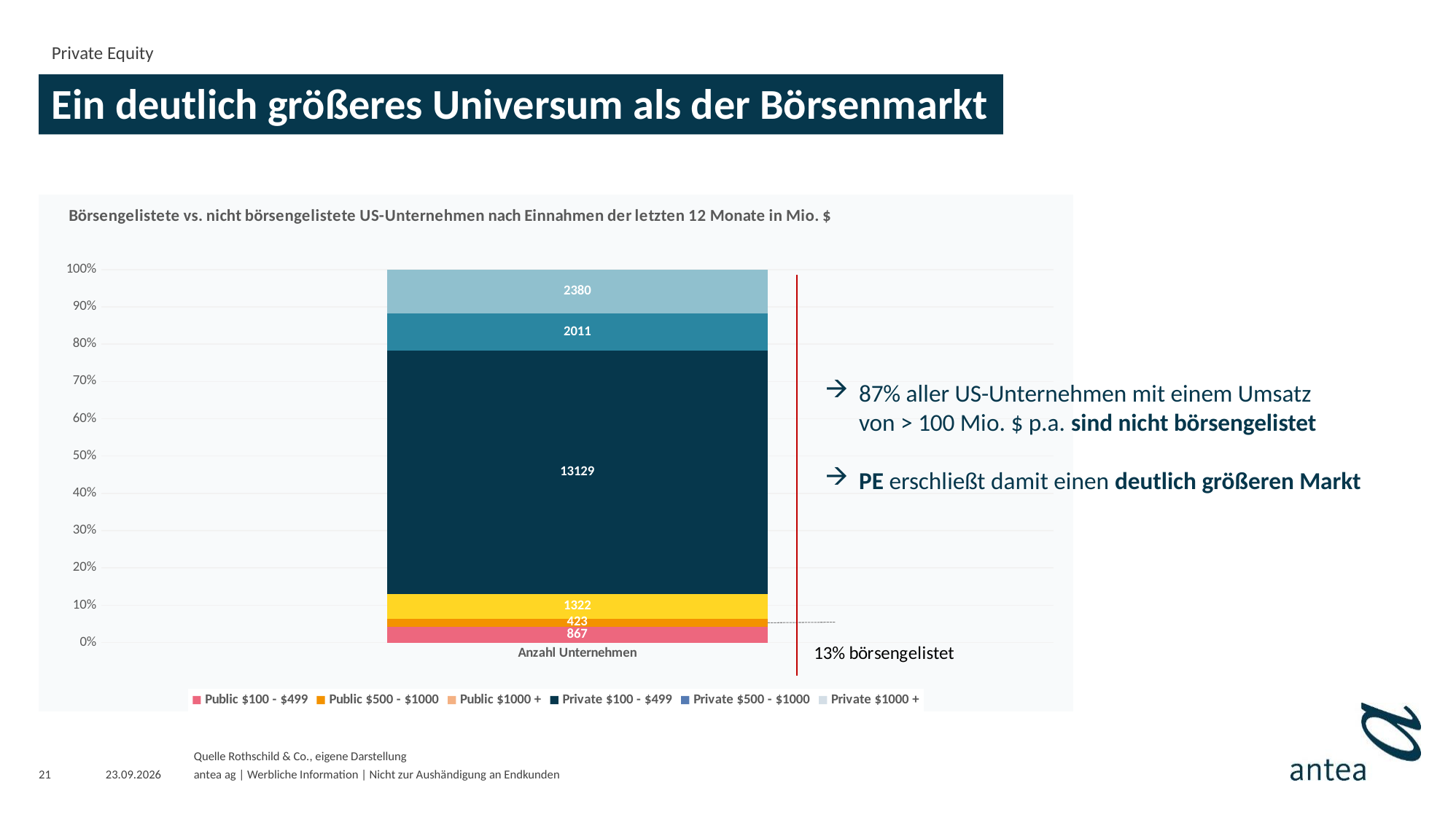
What kind of chart is shown on the slide? Stacked bar chart How many series does the legend list? 6 What value is shown for the Public $100 - $499 segment of the bar? 867 What value is shown for the Private $100 - $499 segment of the bar? 13129 What is the category label shown under the bar on the x axis? Anzahl Unternehmen What value is shown for the Private $1000 + segment of the bar? 2380 Which series has the smallest value in the bar? Public $500 - $1000 What is the difference between the Private $1000 + value and the Private $500 - $1000 value? 369 Which series has the largest value in the bar? Private $100 - $499 What value is shown for the Public $500 - $1000 segment of the bar? 423 What is the total of all segments in the bar? 20132 Which is larger, the Public $1000 + value or the Public $100 - $499 value? Public $1000 +